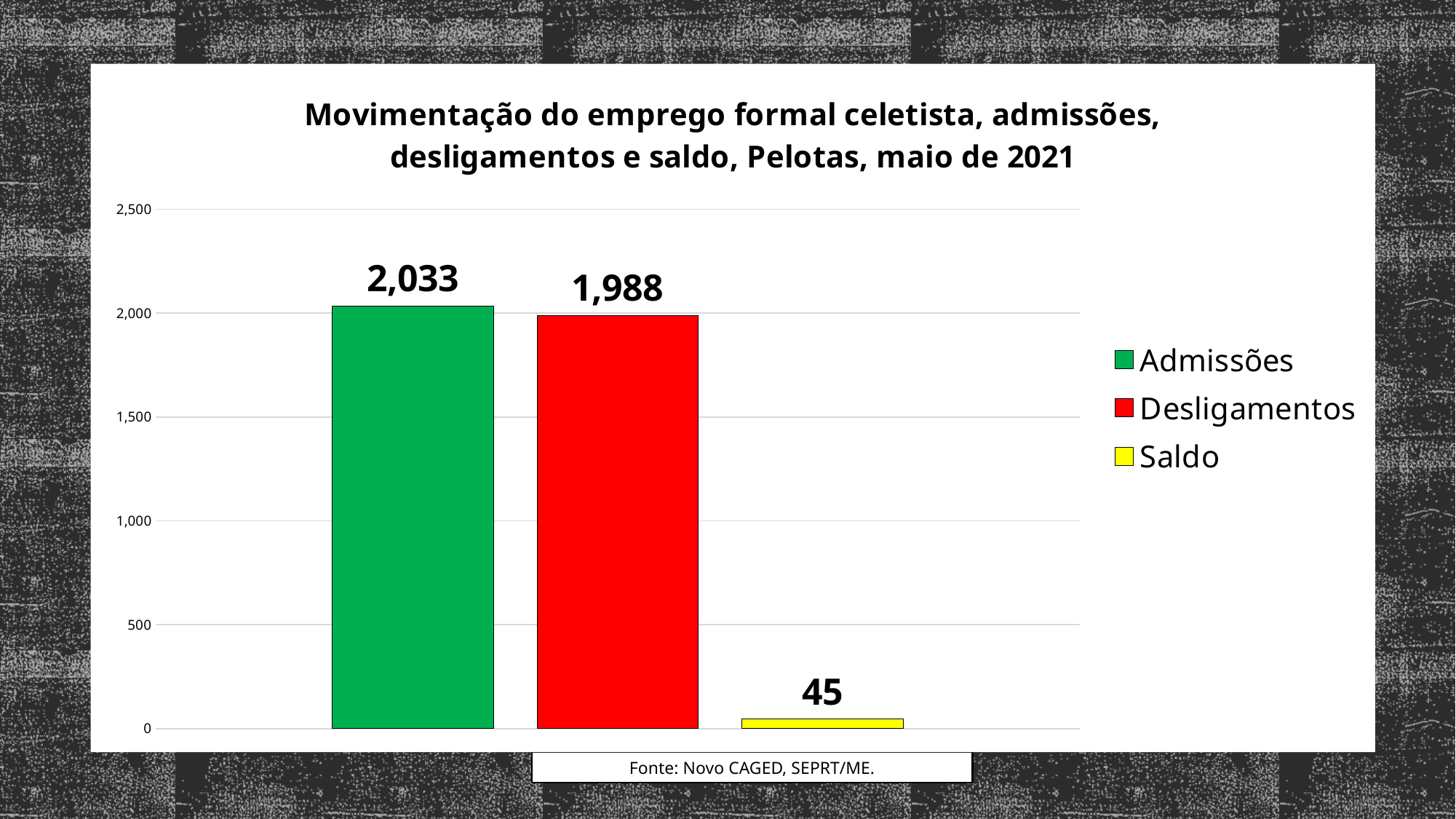
What source is cited below the chart? Novo CAGED, SEPRT/ME. What colour is the bar for Saldo? yellow Which is larger, Admissões or Desligamentos? Admissões What kind of chart is shown? bar chart What is the value for Admissões? 2,033 Which series has the lowest value? Saldo Which series has the highest value? Admissões What is the value for Saldo? 45 What is the value for Desligamentos? 1,988 What is the difference between Admissões and Desligamentos? 45 Is the value for Desligamentos greater or less than 2,000? less How many series does the legend list? 3